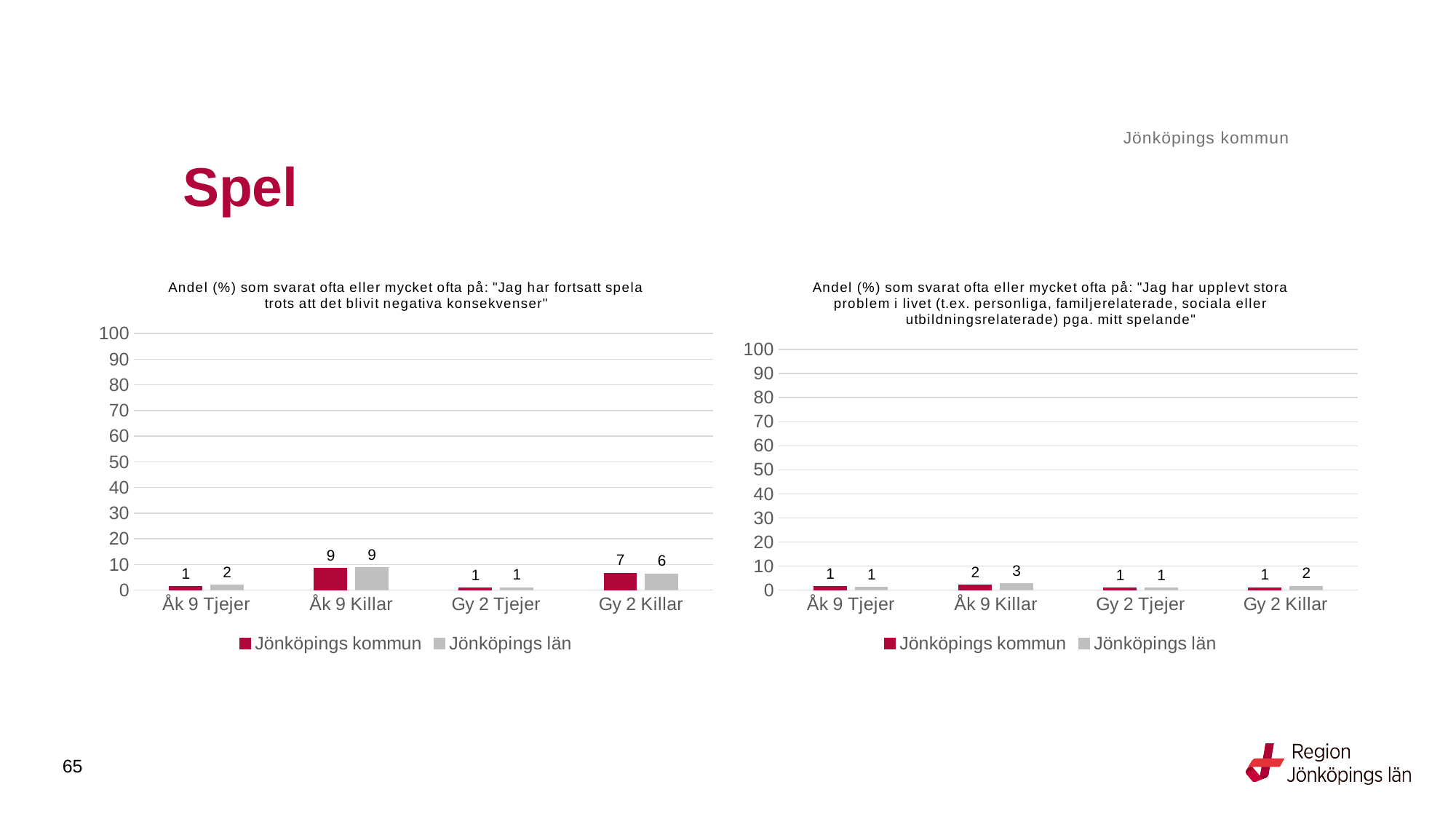
How many categories are shown on the x axis of the left chart? 4 In the right chart, what is the value for Jönköpings kommun for Gy 2 Killar? 1 In the left chart, which is larger for Åk 9 Tjejer: Jönköpings kommun or Jönköpings län? Jönköpings län What kind of chart is the left chart? Bar chart In the right chart, what is the difference between Jönköpings län and Jönköpings kommun for Gy 2 Killar? 1 In the right chart, what is the value for Jönköpings län for Åk 9 Killar? 3 In the left chart, what is the value for Jönköpings län for Gy 2 Killar? 6 In the left chart, what is the difference between Jönköpings kommun and Jönköpings län for Gy 2 Killar? 1 In the left chart, which category has the highest value for Jönköpings kommun? Åk 9 Killar In the right chart, which category has the highest value for Jönköpings län? Åk 9 Killar In the left chart, what is the value for Jönköpings kommun for Åk 9 Killar? 9 How many series does the legend of the right chart list? 2